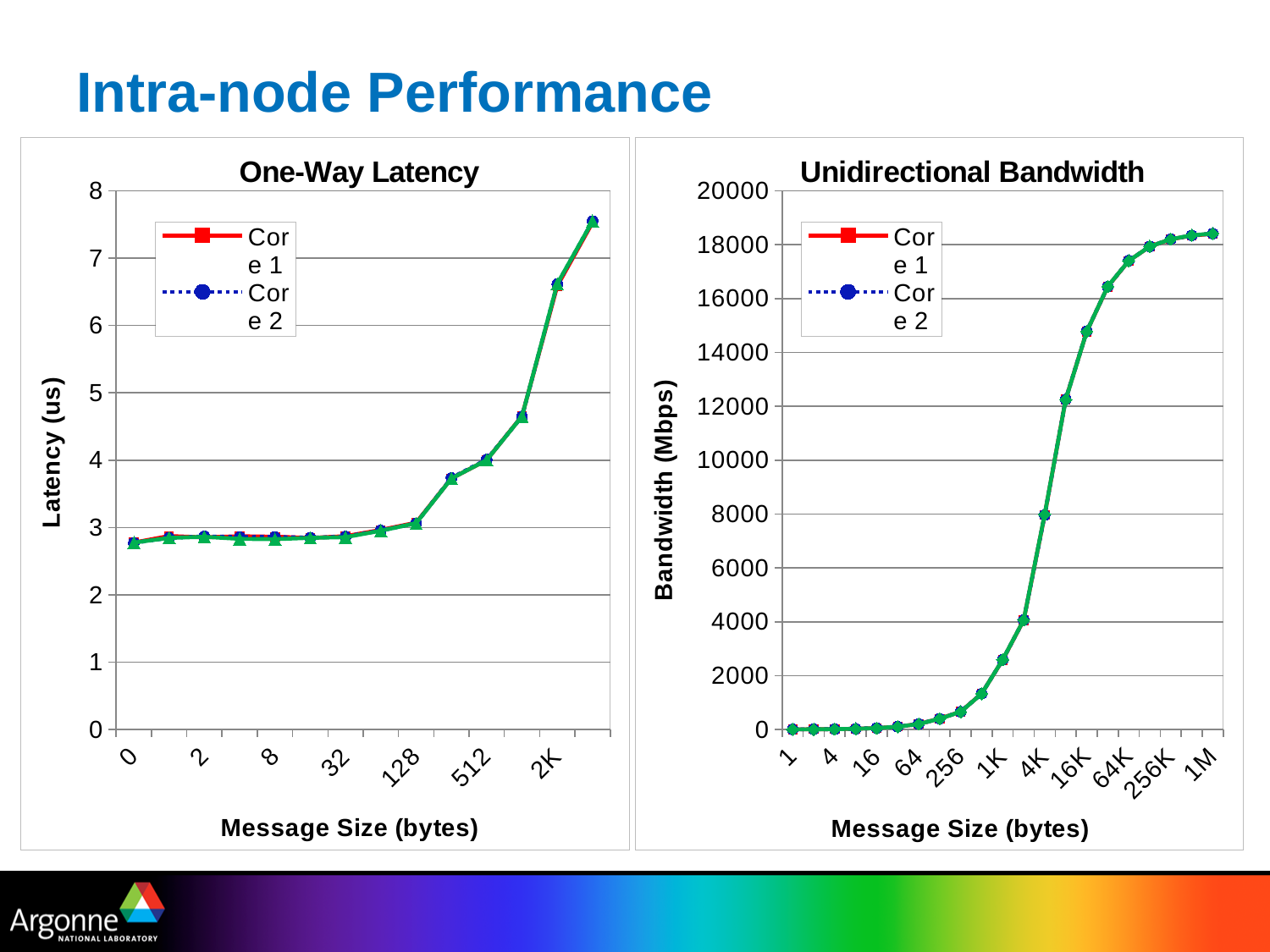
What is the x-axis label of the One-Way Latency chart? Message Size (bytes) In the Unidirectional Bandwidth chart, does bandwidth rise or fall as message size increases along the x axis? rise In the One-Way Latency chart, is the latency at message size 0 greater or less than 4? less In the One-Way Latency chart, is the latency at message size 2K greater or less than 6? greater How many series does the legend of the Unidirectional Bandwidth chart list? 2 How many series does the legend of the One-Way Latency chart list? 2 In the Unidirectional Bandwidth chart, is the bandwidth at message size 256 greater or less than 2000? less What kind of chart is the Unidirectional Bandwidth chart? line chart In the One-Way Latency chart, does latency rise or fall overall as message size increases along the x axis? rise What kind of chart is the One-Way Latency chart? line chart What is the y-axis label of the Unidirectional Bandwidth chart? Bandwidth (Mbps)